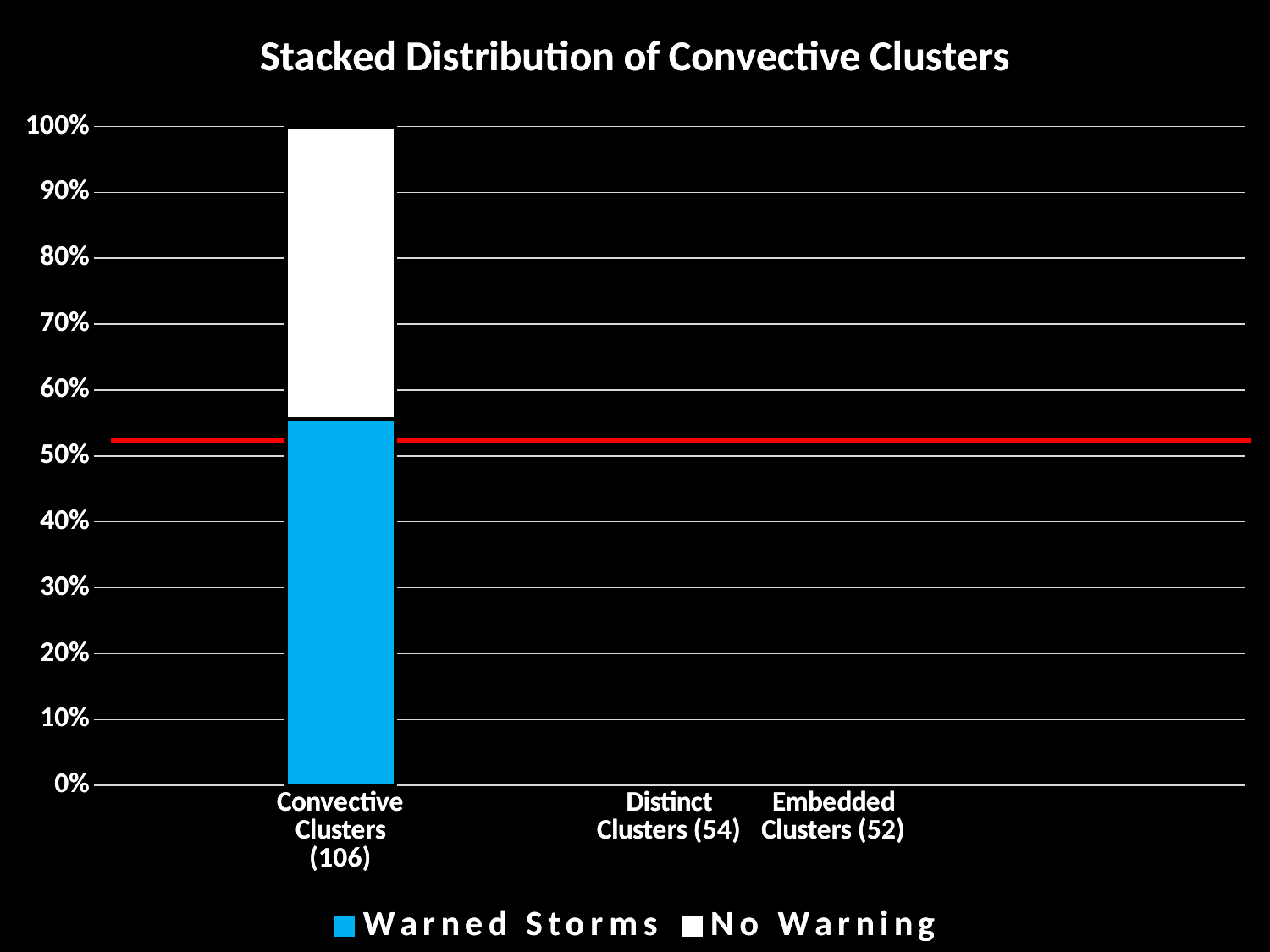
How many series does the legend list? 2 Is the Warned Storms share for Convective Clusters (106) greater or less than 60%? less What is the total height of the stacked bar for Convective Clusters (106)? 100% Is the red horizontal line drawn above or below the 50% gridline? above What kind of chart is shown on the slide? Stacked bar chart How many category labels are shown along the x axis? 3 Is the No Warning share for Convective Clusters (106) greater or less than 50%? less What are the two series named in the legend? Warned Storms and No Warning In the Convective Clusters (106) bar, which segment is larger, Warned Storms or No Warning? Warned Storms Which category on the x axis has a bar plotted? Convective Clusters (106) What is the title of the chart? Stacked Distribution of Convective Clusters